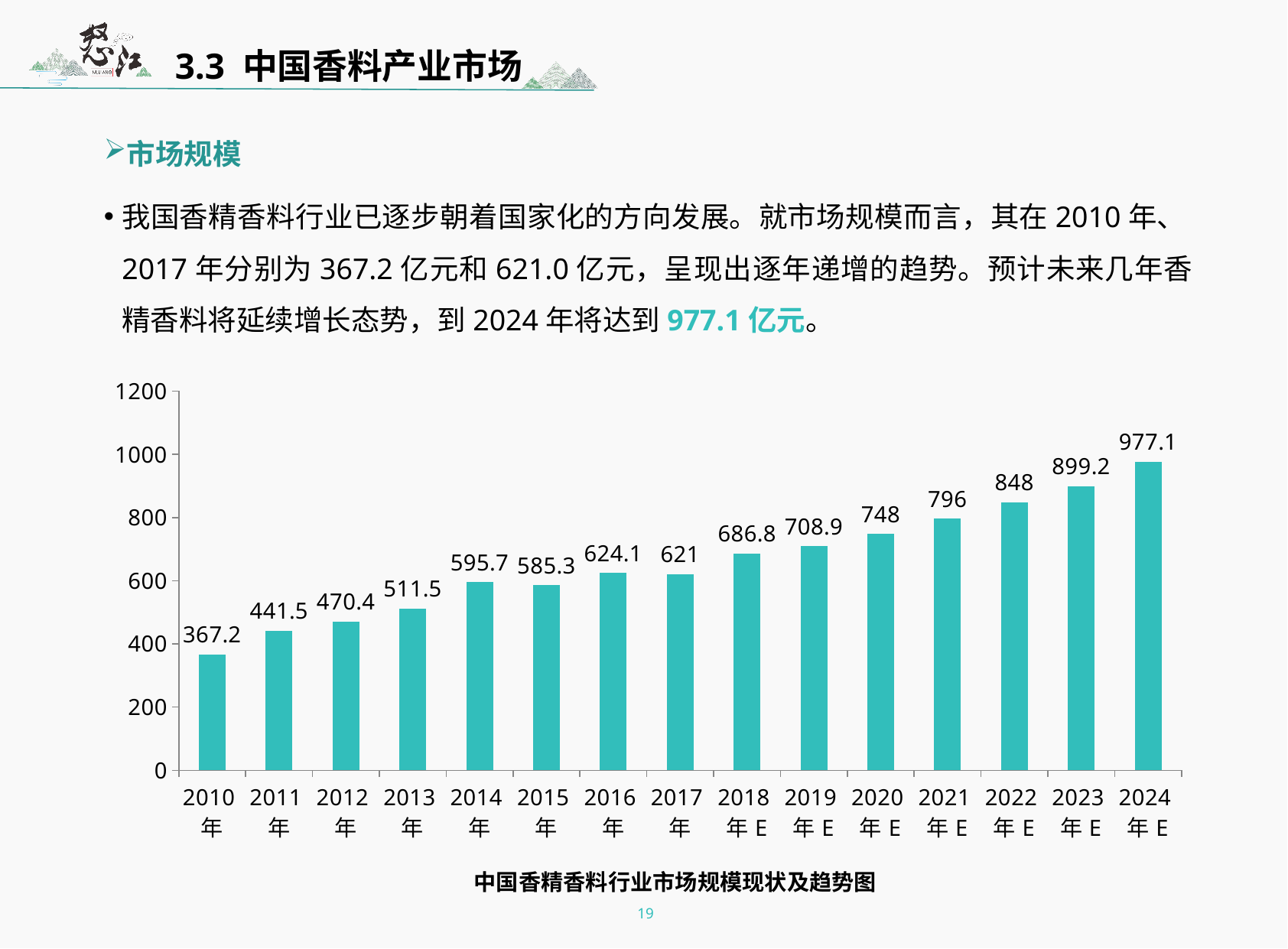
What is the difference between the values for 2024年E and 2010年? 609.9 Do the values generally rise or fall from 2010年 to 2024年E? rise What is the value for 2022年E in the chart? 848 What is the value for 2010年 in the chart? 367.2 What is the title of the chart? 中国香精香料行业市场规模现状及趋势图 Is the value for 2021年E greater or less than 800? less Which year has the lowest value in the chart? 2010年 Which is larger, the value for 2014年 or the value for 2015年? 2014年 How many years are shown on the x axis of the chart? 15 What kind of chart is shown on the slide? bar chart Which year has the highest value in the chart? 2024年E What is the value for 2017年 in the chart? 621